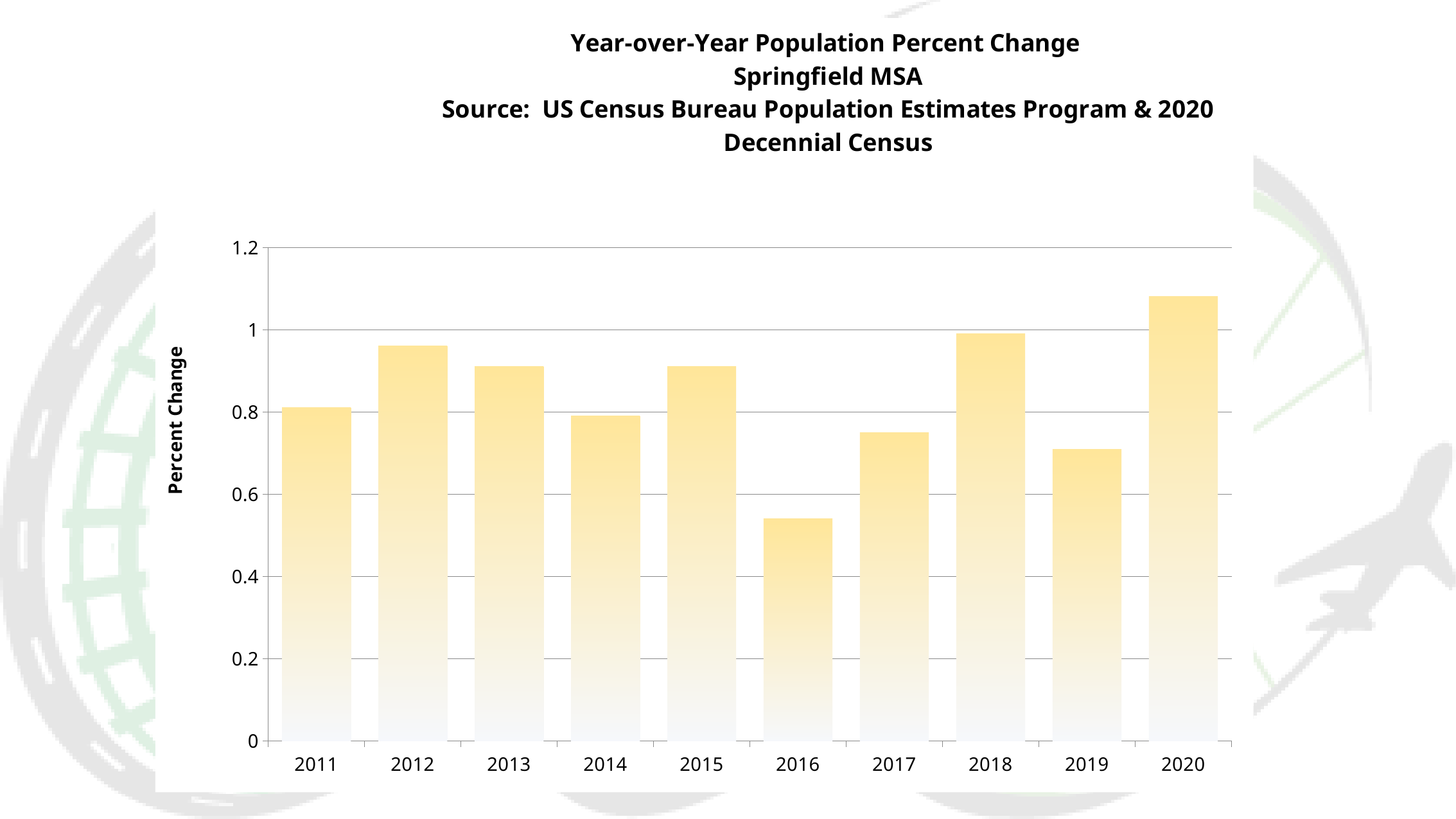
Which year has the lowest year-over-year population percent change? 2016 Which year has the larger percent change, 2012 or 2014? 2012 Which year has the larger percent change, 2018 or 2019? 2018 Is the value for 2020 greater or less than 1? greater Is the value for 2016 greater or less than 0.6? less What kind of chart is shown on the slide? bar chart How many years are shown on the x axis of the chart? 10 Is the value for 2012 greater or less than 0.8? greater Do the values rise or fall from 2016 to 2018? rise Which year has the highest year-over-year population percent change? 2020 What is the label on the vertical axis of the chart? Percent Change